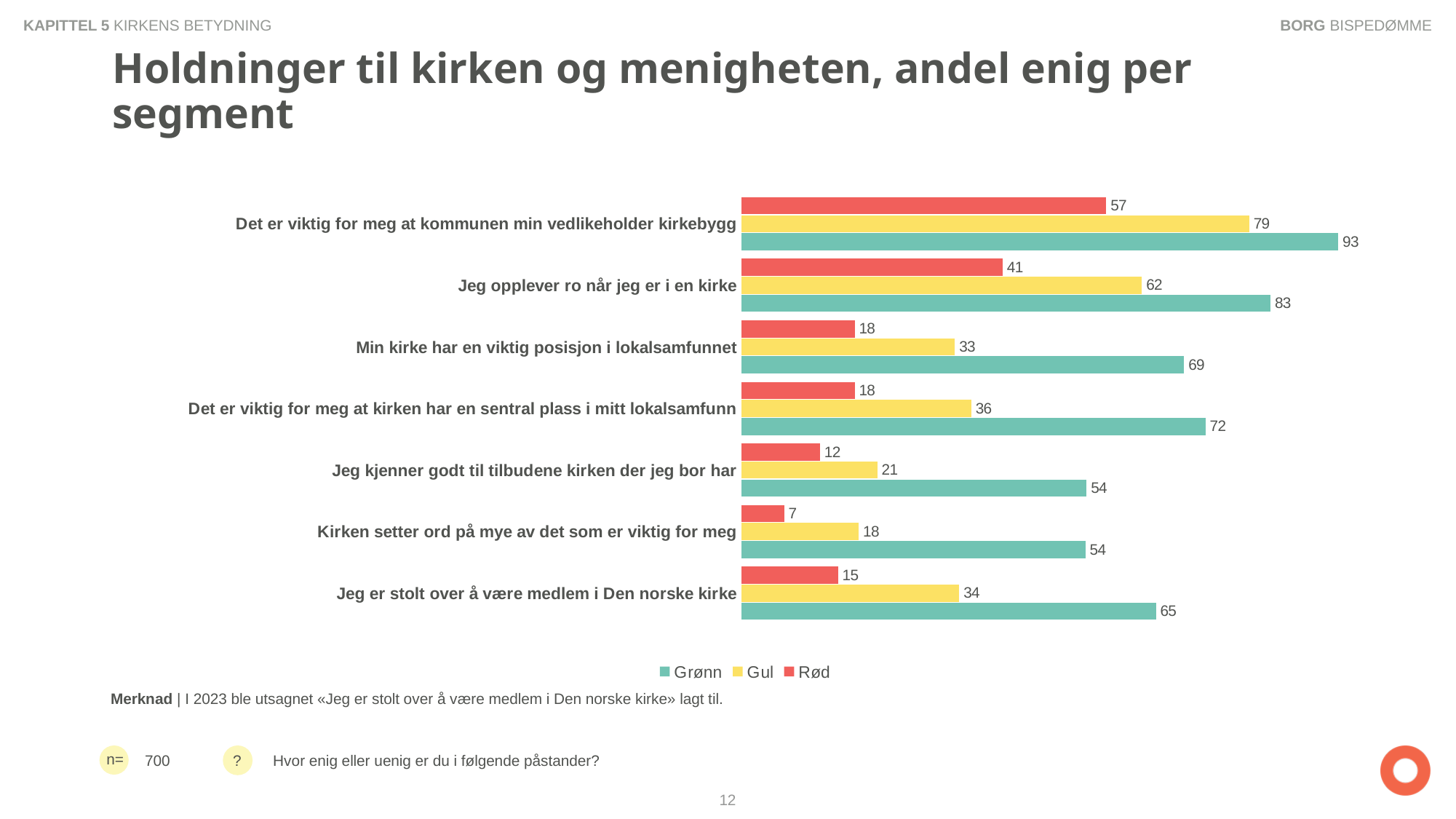
Which series is shown in red in the legend? Rød Which statement has the highest Grønn value? Det er viktig for meg at kommunen min vedlikeholder kirkebygg What kind of chart is shown on the slide? Bar chart What is the Grønn value for "Jeg kjenner godt til tilbudene kirken der jeg bor har"? 54 How many series does the legend list? 3 What is the Gul value for "Jeg er stolt over å være medlem i Den norske kirke"? 34 How many statements (categories) are shown in the chart? 7 What is the difference between the Grønn and Rød values for "Min kirke har en viktig posisjon i lokalsamfunnet"? 51 Which statement has the lowest Rød value? Kirken setter ord på mye av det som er viktig for meg What is the Rød value for "Jeg opplever ro når jeg er i en kirke"? 41 What is the Grønn value for "Det er viktig for meg at kommunen min vedlikeholder kirkebygg"? 93 Which is larger: the Gul value for "Jeg opplever ro når jeg er i en kirke" or the Gul value for "Det er viktig for meg at kirken har en sentral plass i mitt lokalsamfunn"? Jeg opplever ro når jeg er i en kirke